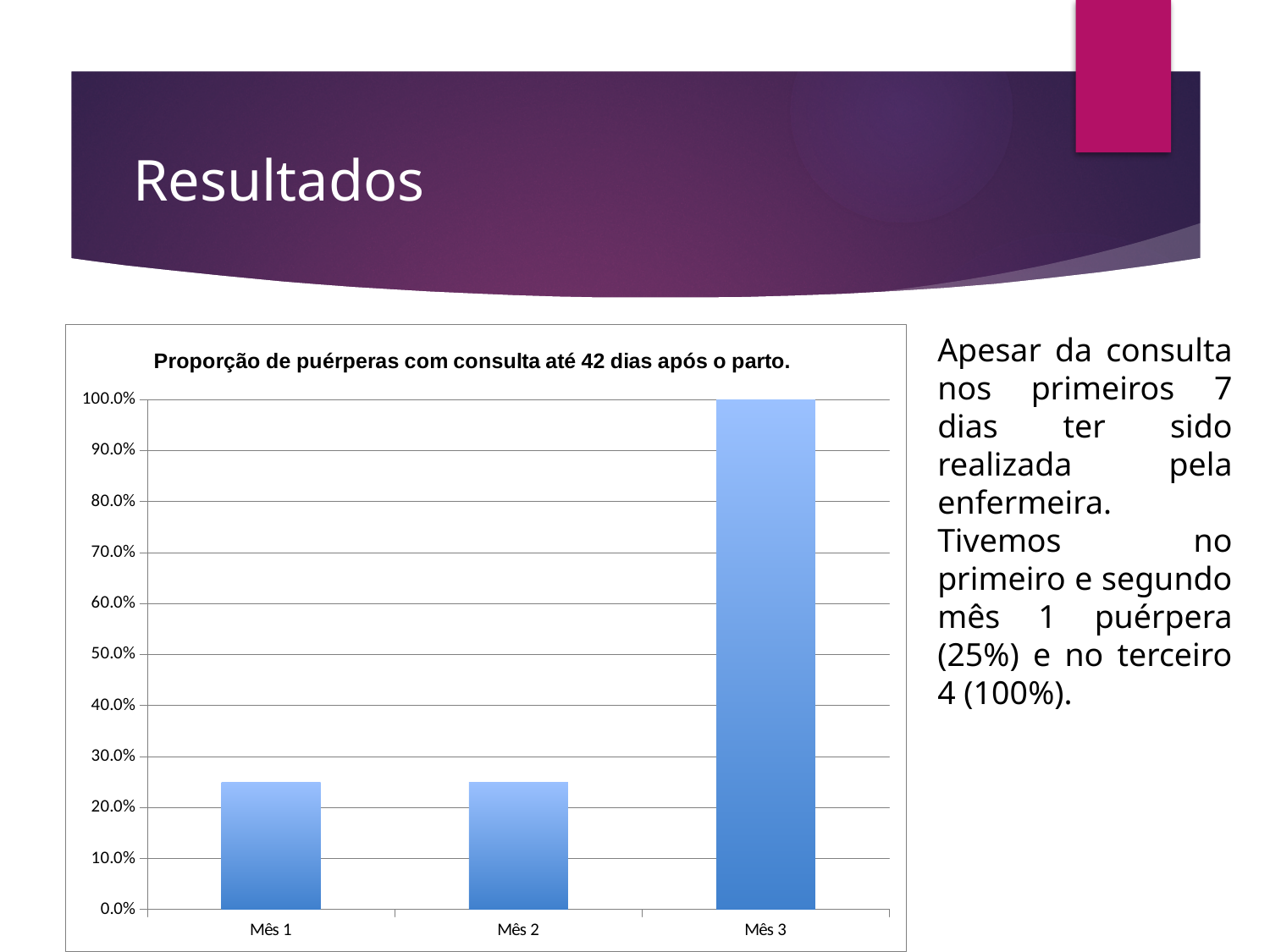
Is the value for Mês 3 greater or less than 90.0%? greater Is the value for Mês 1 greater or less than 30.0%? less Which is larger, the value for Mês 1 or the value for Mês 3? Mês 3 What is the value for Mês 3? 100.0% Which month has the highest value in the chart? Mês 3 Which is larger, the value for Mês 2 or the value for Mês 3? Mês 3 What is the highest value shown on the y axis of the chart? 100.0% Does the value rise or fall from Mês 2 to Mês 3? rise What kind of chart is shown on the slide? bar chart How many categories are shown on the x axis of the chart? 3 Is the value for Mês 2 greater or less than 20.0%? greater What is the title of the chart? Proporção de puérperas com consulta até 42 dias após o parto.